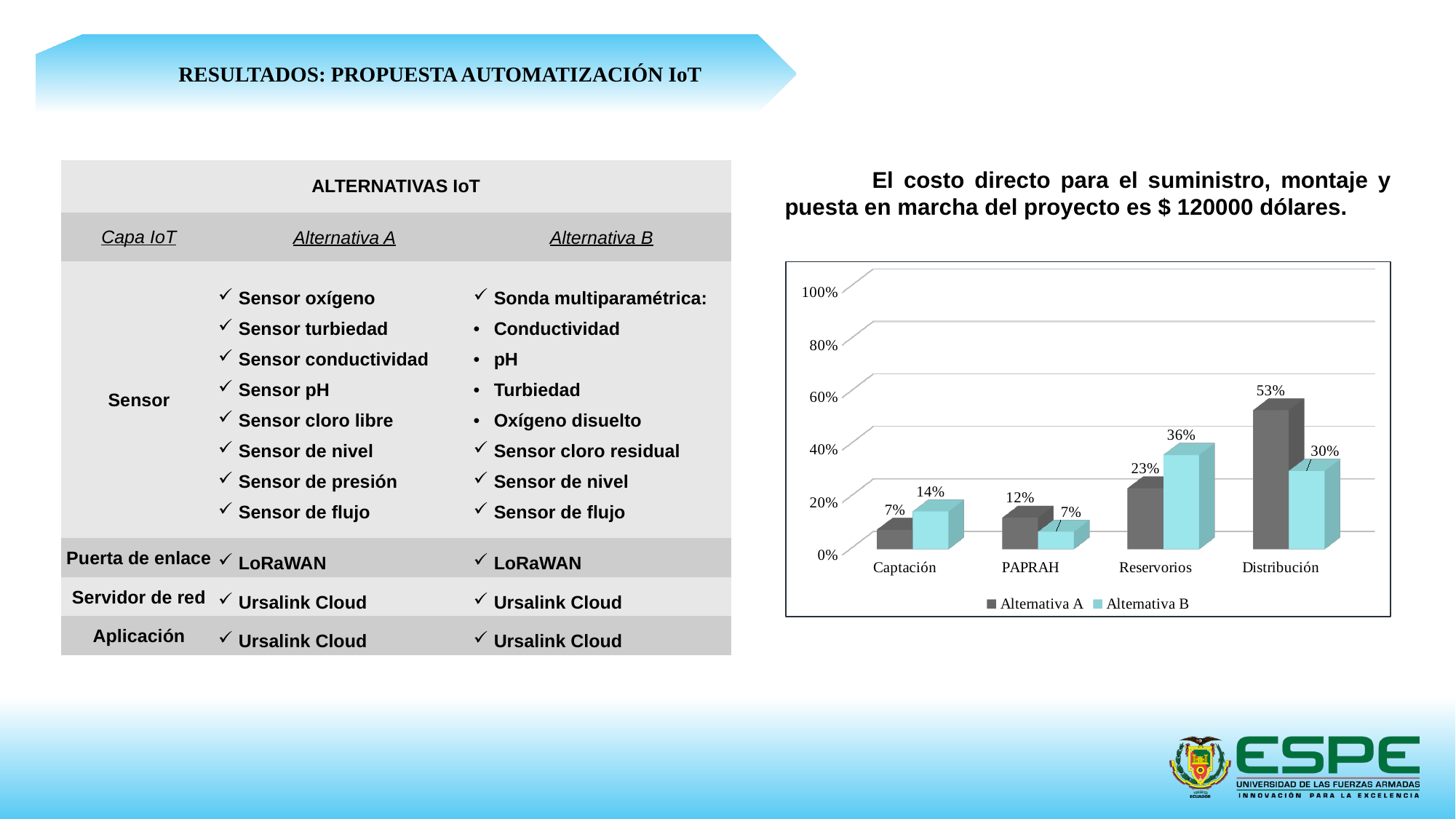
What is the value for Alternativa B in the PAPRAH category? 7% What kind of chart is shown on the slide? Bar chart What is the value for Alternativa A in the Reservorios category? 23% What are the two series named in the chart legend? Alternativa A and Alternativa B What is the value for Alternativa B in the Captación category? 14% Which category has the highest value for Alternativa A? Distribución How many categories are shown on the x axis of the chart? 4 Which category has the lowest value for Alternativa B? PAPRAH How many series does the chart legend list? 2 Which is larger in the Reservorios category, Alternativa A or Alternativa B? Alternativa B What is the value for Alternativa A in the Distribución category? 53% What is the difference between Alternativa A and Alternativa B in the Distribución category? 23%